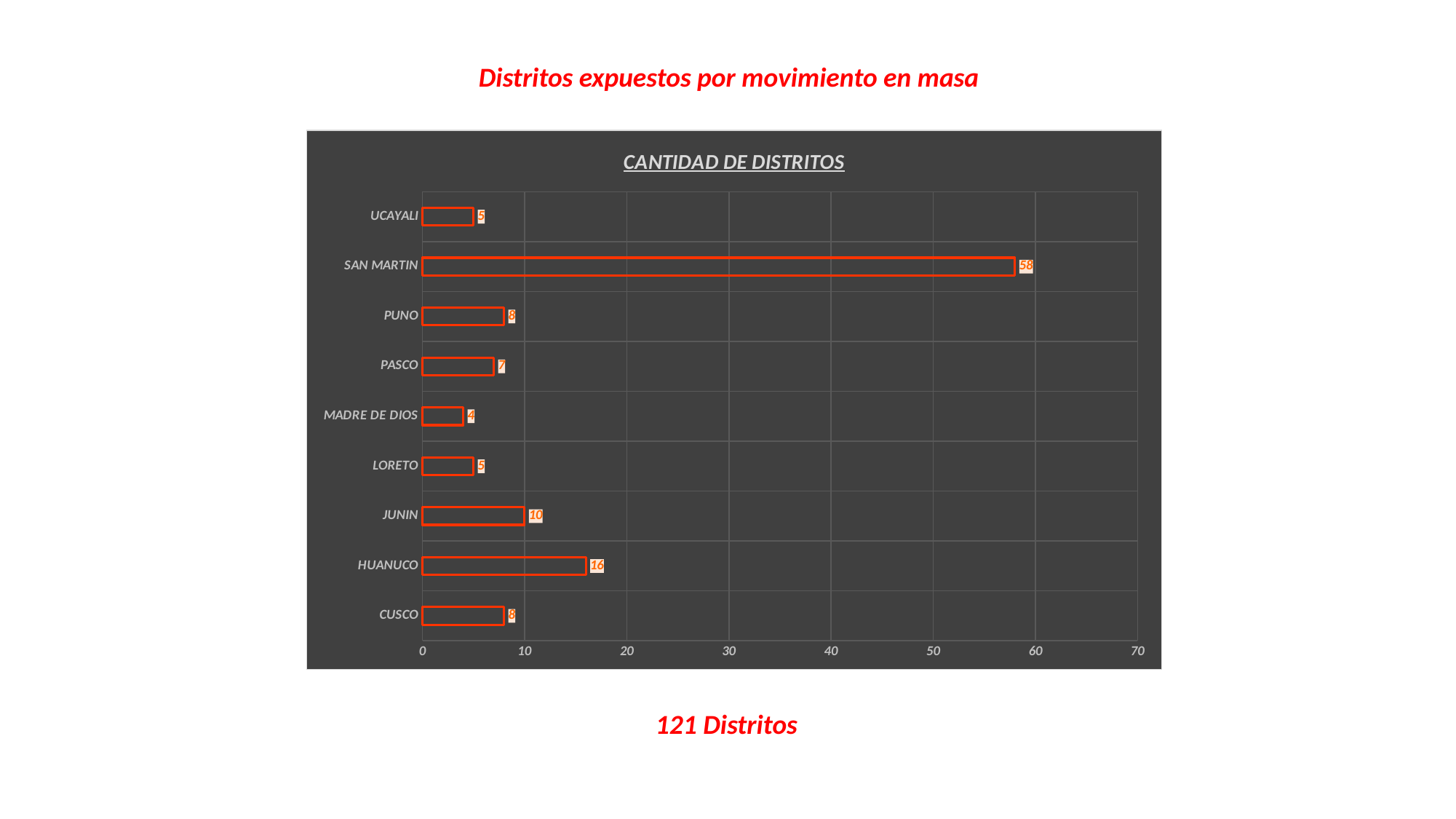
What is the value for HUANUCO? 16 What is the difference between the values for SAN MARTIN and HUANUCO? 42 Is the value for SAN MARTIN greater or less than 50? greater How many categories are shown on the chart? 9 Which category has the lowest value? MADRE DE DIOS What kind of chart is shown on the slide? bar chart What is the value for SAN MARTIN? 58 What is the title of the chart? CANTIDAD DE DISTRITOS Which is larger, the value for JUNIN or the value for PASCO? JUNIN What is the value for MADRE DE DIOS? 4 What is the value for JUNIN? 10 Which category has the highest value? SAN MARTIN